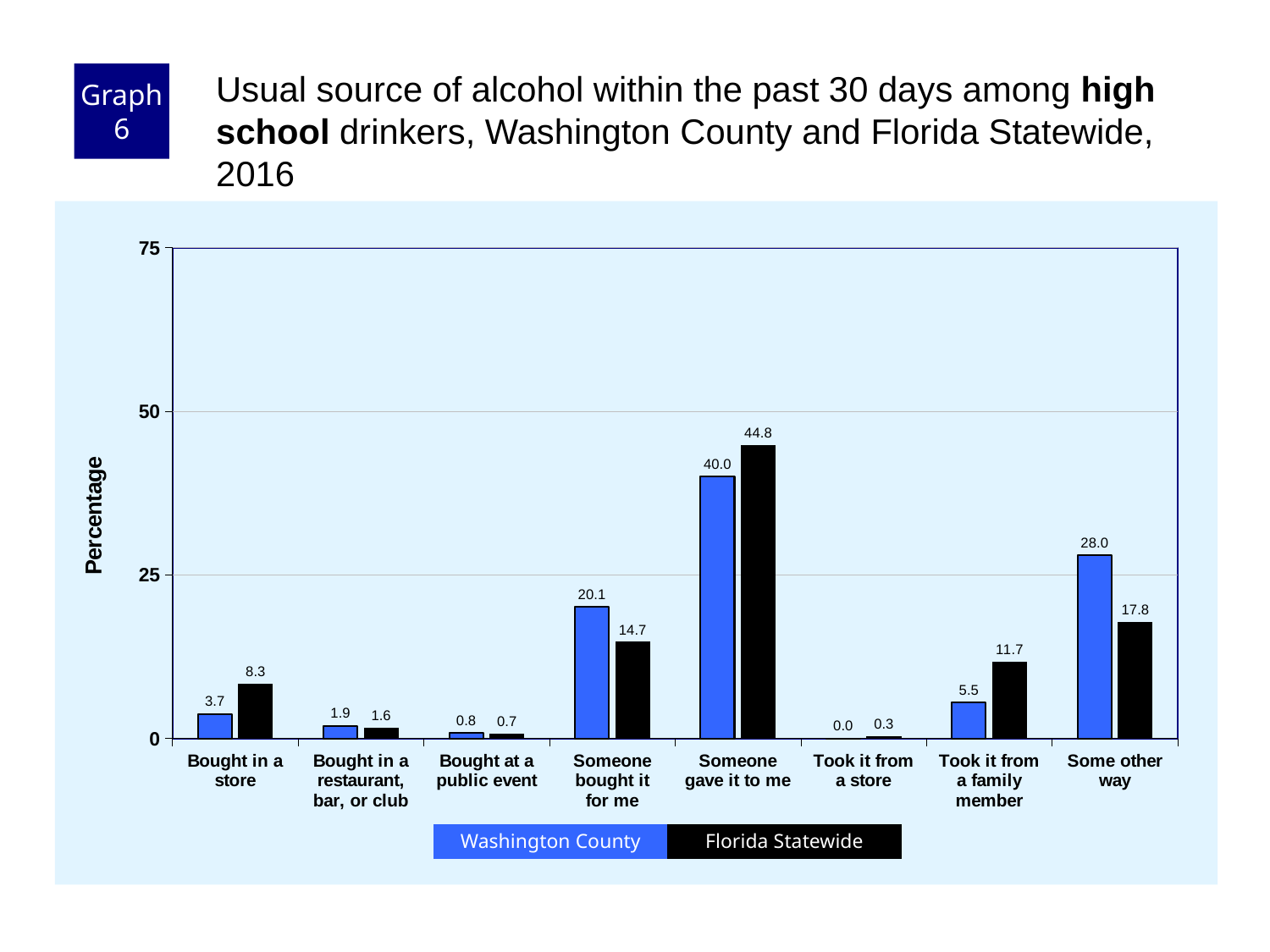
How many series does the legend list? 2 Which category has the highest Florida Statewide value? Someone gave it to me What is the Washington County value for "Some other way"? 28.0 What kind of chart is shown on the slide? bar chart Which category has the lowest Washington County value? Took it from a store What is the Florida Statewide value for "Took it from a family member"? 11.7 What is the Washington County value for "Someone gave it to me"? 40.0 What is the difference between the Washington County and Florida Statewide values for "Someone bought it for me"? 5.4 For "Bought in a store", which is larger: Washington County or Florida Statewide? Florida Statewide How many categories are shown on the x axis? 8 Is the Florida Statewide value for "Some other way" greater or less than 25? less What is the difference between the Florida Statewide and Washington County values for "Someone gave it to me"? 4.8